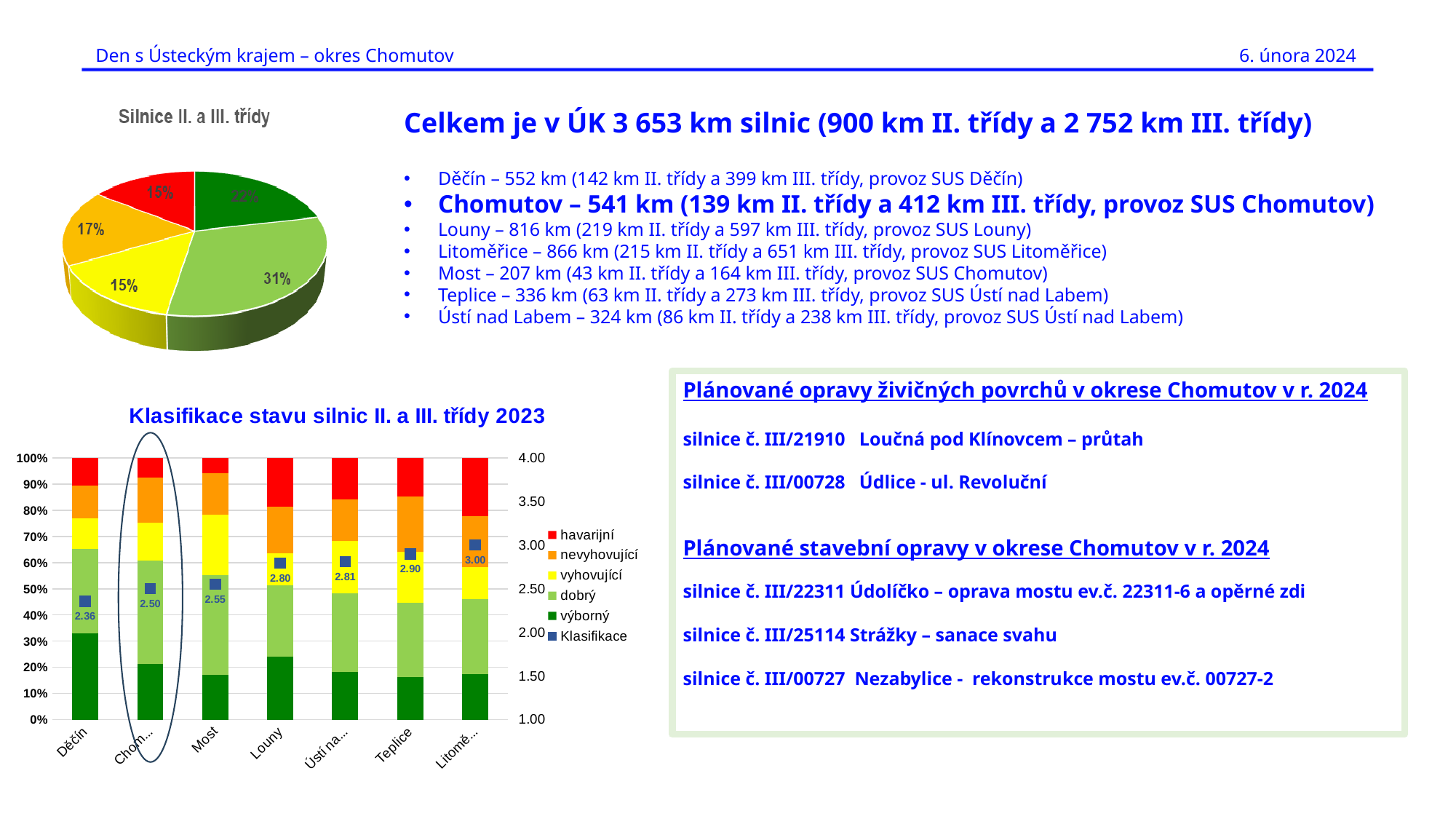
How many districts are shown on the x axis of the chart 'Klasifikace stavu silnic II. a III. třídy 2023'? 7 In the chart 'Klasifikace stavu silnic II. a III. třídy 2023', what is the Klasifikace value for Teplice? 2.90 In the chart 'Klasifikace stavu silnic II. a III. třídy 2023', what is the Klasifikace value for Děčín? 2.36 In the pie chart 'Silnice II. a III. třídy', what is the share of the largest slice? 31% In the chart 'Klasifikace stavu silnic II. a III. třídy 2023', do the Klasifikace values rise or fall from left to right along the x axis? rise How many entries does the legend of the chart 'Klasifikace stavu silnic II. a III. třídy 2023' list? 6 What kind of chart is the chart titled 'Silnice II. a III. třídy'? pie chart In the chart 'Klasifikace stavu silnic II. a III. třídy 2023', which has the higher Klasifikace value, Louny or Most? Louny What kind of chart is 'Klasifikace stavu silnic II. a III. třídy 2023'? stacked bar chart In the chart 'Klasifikace stavu silnic II. a III. třídy 2023', what is the difference between the Klasifikace values of Teplice and Děčín? 0.54 In the chart 'Klasifikace stavu silnic II. a III. třídy 2023', which district has the lowest Klasifikace value? Děčín How many slices does the pie chart 'Silnice II. a III. třídy' have? 5